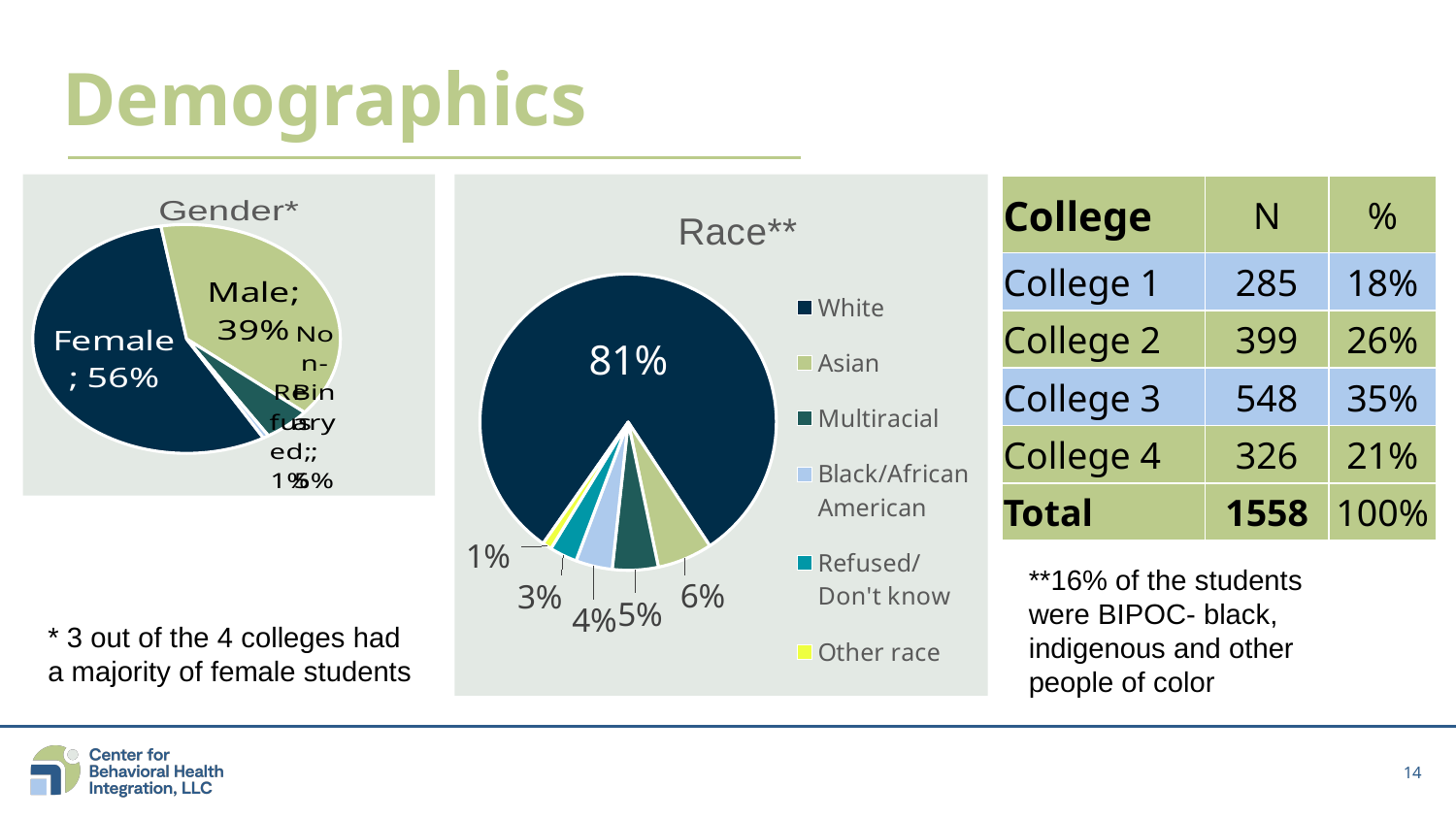
In the Gender* pie chart, what percentage is shown for Male? 39% In the Race** pie chart, which category has the largest share? White In the Race** pie chart, which is larger, Multiracial or Black/African American? Multiracial In the Race** pie chart, which category has the smallest share? Other race In the Race** pie chart, what percentage is shown for Refused/Don't know? 3% In the Gender* pie chart, what is the difference in percentage points between Female and Male? 17 percentage points In the Race** pie chart, what percentage is shown for Asian? 6% What kind of chart is the Race** chart? Pie chart In the Race** pie chart, what percentage is shown for White? 81% How many categories does the legend of the Race** chart list? 6 In the Gender* pie chart, what percentage is shown for Female? 56% In the Gender* pie chart, which slice is larger, Female or Male? Female